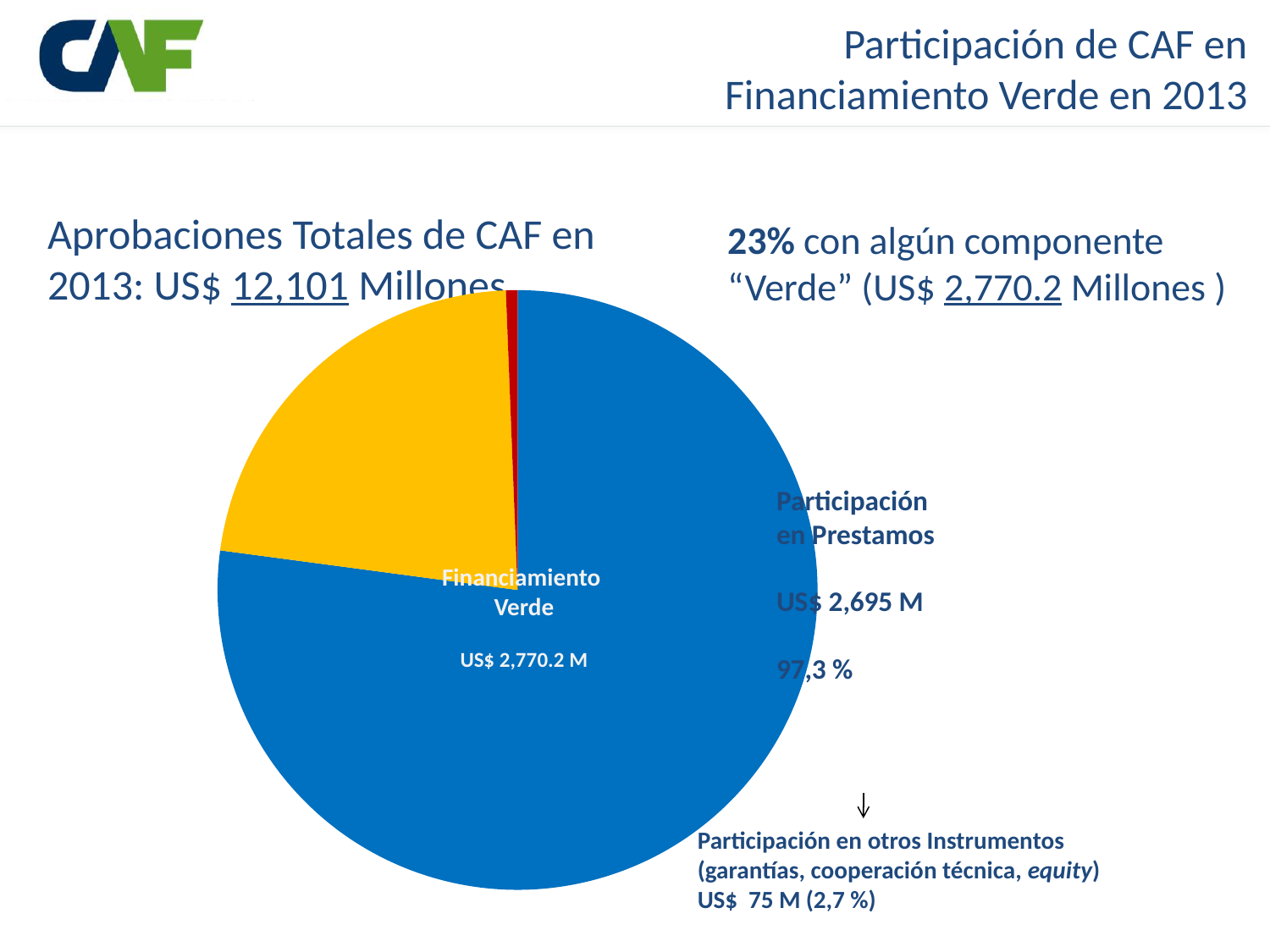
What percentage is shown for Participación en otros Instrumentos? 2,7 % What percentage is shown for Participación en Prestamos? 97,3 % What amount is shown for Participación en otros Instrumentos (garantías, cooperación técnica, equity)? US$ 75 M What colour is the largest slice of the pie chart? Blue What kind of chart is shown on the slide? Pie chart What amount is shown for Participación en Prestamos? US$ 2,695 M What percentage of CAF's 2013 approvals had some 'Verde' component? 23% Which is larger, Participación en Prestamos or Participación en otros Instrumentos? Participación en Prestamos What is the difference between the amount for Participación en Prestamos and the amount for Participación en otros Instrumentos? US$ 2,620 M What were CAF's total approvals in 2013 according to the slide? US$ 12,101 Millones How many slices does the pie chart have? 3 What amount is shown for Financiamiento Verde on the pie chart? US$ 2,770.2 M